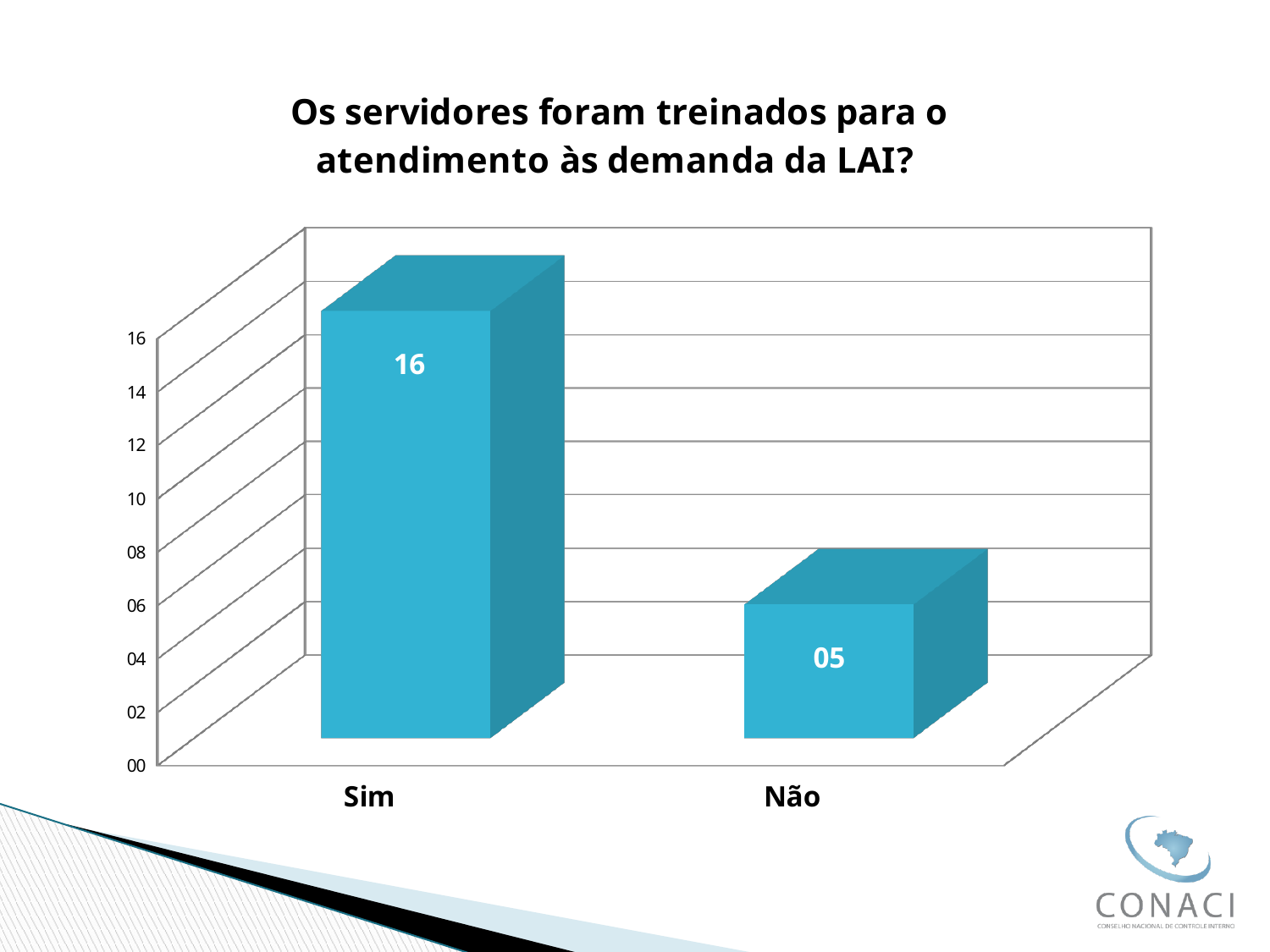
Which category has the lowest value? Não Which category has the highest value? Sim What is the value for Sim? 16 What is the value for Não? 05 Is the value for Não greater or less than 10? less What is the difference between the values for Sim and Não? 11 What kind of chart is shown on the slide? bar chart What colour are the bars in the chart? blue Which is larger, the value for Sim or the value for Não? Sim Is the value for Sim greater or less than 10? greater What is the title of the chart? Os servidores foram treinados para o atendimento às demanda da LAI? How many categories are shown in the chart? 2